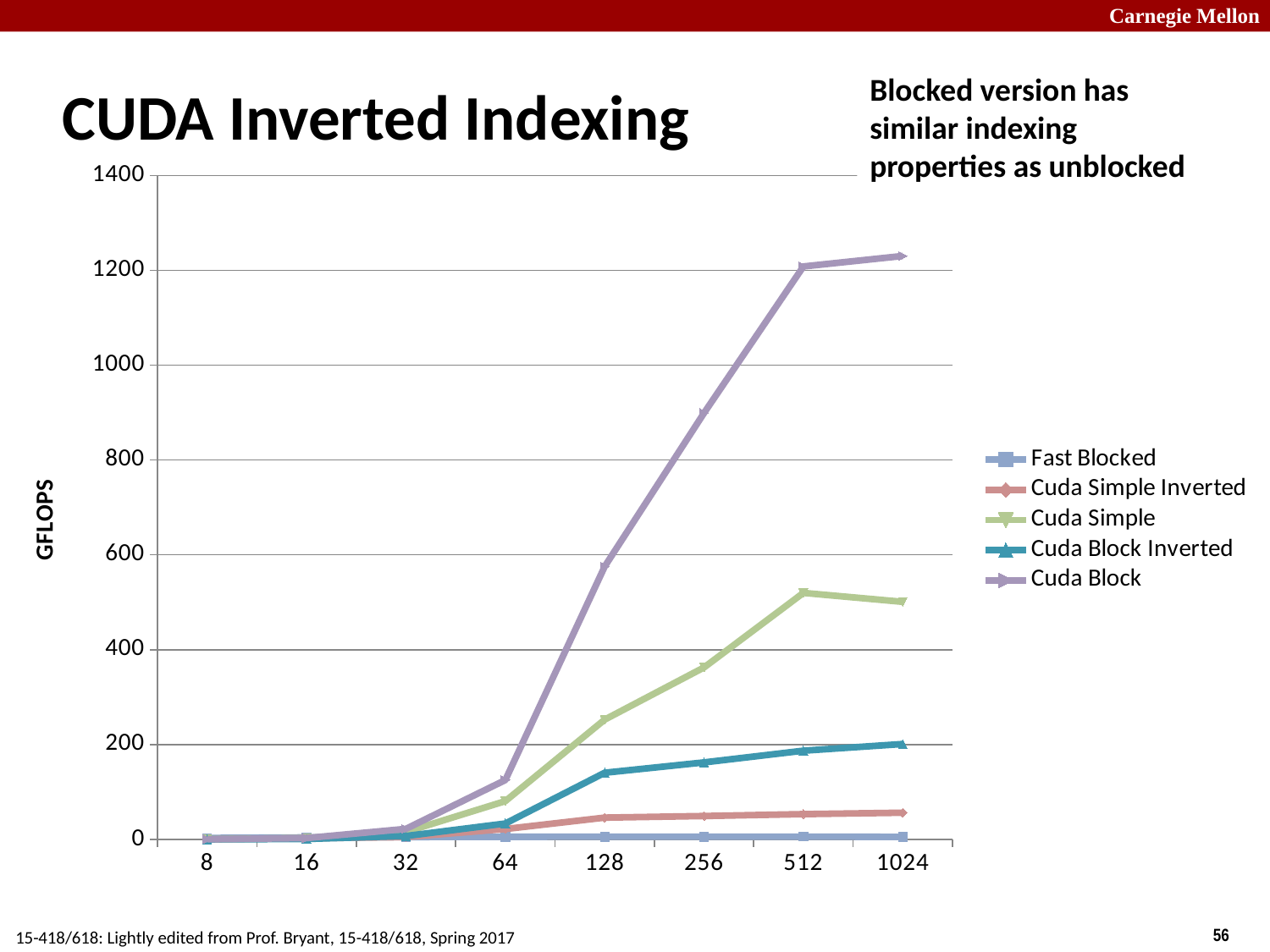
What kind of chart is shown on the slide? line chart Is the value for Cuda Block Inverted at x = 1024 greater or less than 400? less Is the value for Cuda Simple at x = 512 greater or less than 400? greater How many points are marked along the x axis? 8 Which series has the highest value at x = 1024? Cuda Block Is the value for Cuda Block at x = 256 greater or less than 800? greater Which series has the lowest value at x = 1024? Fast Blocked How many series does the legend list? 5 Does the Cuda Block series rise or fall as x increases from 8 to 512? rise At x = 512, which is larger: Cuda Simple or Cuda Block Inverted? Cuda Simple What is the label on the y axis? GFLOPS